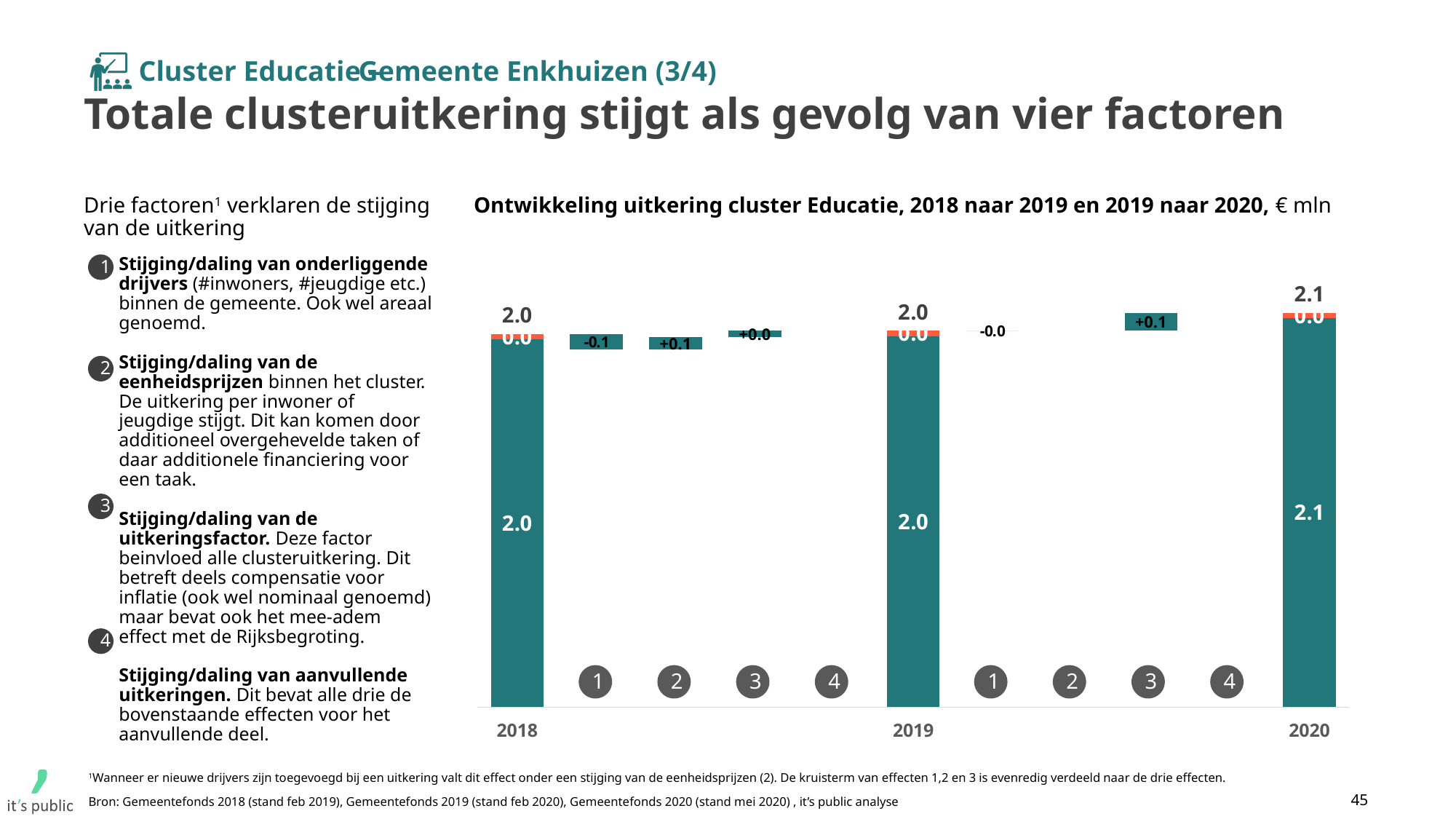
In what unit are the values in the chart expressed? € mln What kind of chart is this? bar chart (waterfall) What is the value of factor 1 in the change from 2018 to 2019? -0.1 What is the value of factor 2 in the change from 2018 to 2019? +0.1 How many year totals are shown in the chart? 3 What is the total uitkering for 2018? 2.0 What is the difference between the total for 2020 and the total for 2018? 0.1 What is the total uitkering for 2019? 2.0 Which year has the highest total uitkering? 2020 What is the total uitkering for 2020? 2.1 Is the total for 2020 larger or smaller than the total for 2019? larger What is the value of factor 3 in the change from 2019 to 2020? +0.1